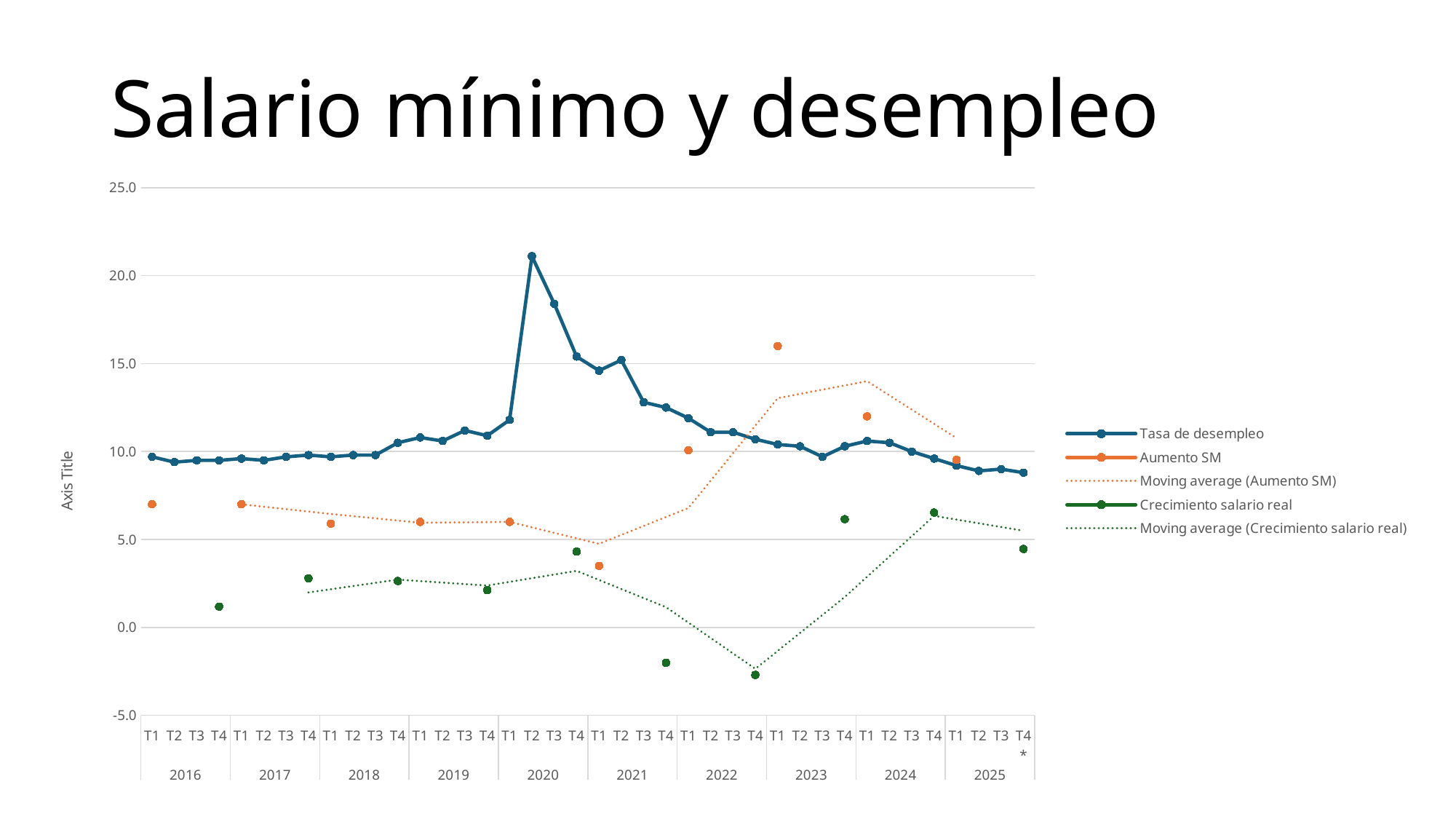
Does the Tasa de desempleo series rise or fall from T2 2020 to T4 2025? fall Is the value of Aumento SM in T1 2023 greater or less than 15.0? greater What is the title of the slide? Salario mínimo y desempleo Which is larger, the Aumento SM value in T1 2023 or the Aumento SM value in T1 2024? T1 2023 Is the value of Tasa de desempleo in T2 2020 greater or less than 20.0? greater What kind of chart is shown on the slide? line chart How many series does the legend list? 5 How many years are labelled on the x axis? 10 Is the value of Crecimiento salario real in T4 2022 greater or less than 0.0? less In which quarter and year does the Tasa de desempleo series reach its highest value? T2 2020 In which quarter and year does the Crecimiento salario real series reach its lowest value? T4 2022